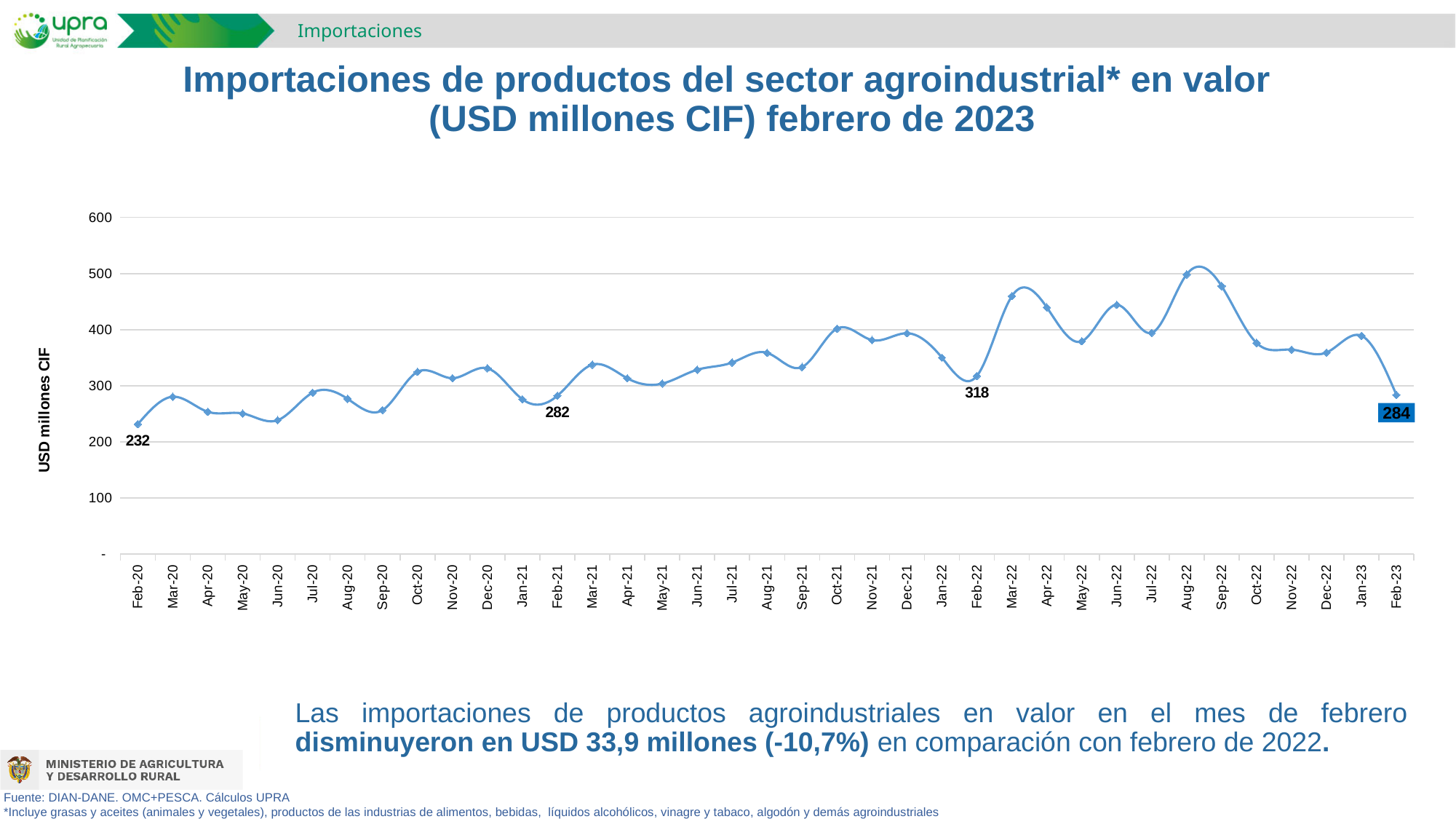
What kind of chart is shown on the slide? line chart What is the difference between the values for Feb-22 and Feb-23? 34 Is the value for Jun-20 greater or less than 300? less Which is larger, the value for Feb-22 or the value for Feb-23? Feb-22 What is the value for Feb-21? 282 Is the value for Aug-22 greater or less than 400? greater What is the value for Feb-23? 284 What is the value for Feb-22? 318 What is the value for Feb-20? 232 How many monthly data points are plotted on the chart? 37 What is the difference between the values for Feb-21 and Feb-20? 50 Which month has the highest value on the chart? Aug-22